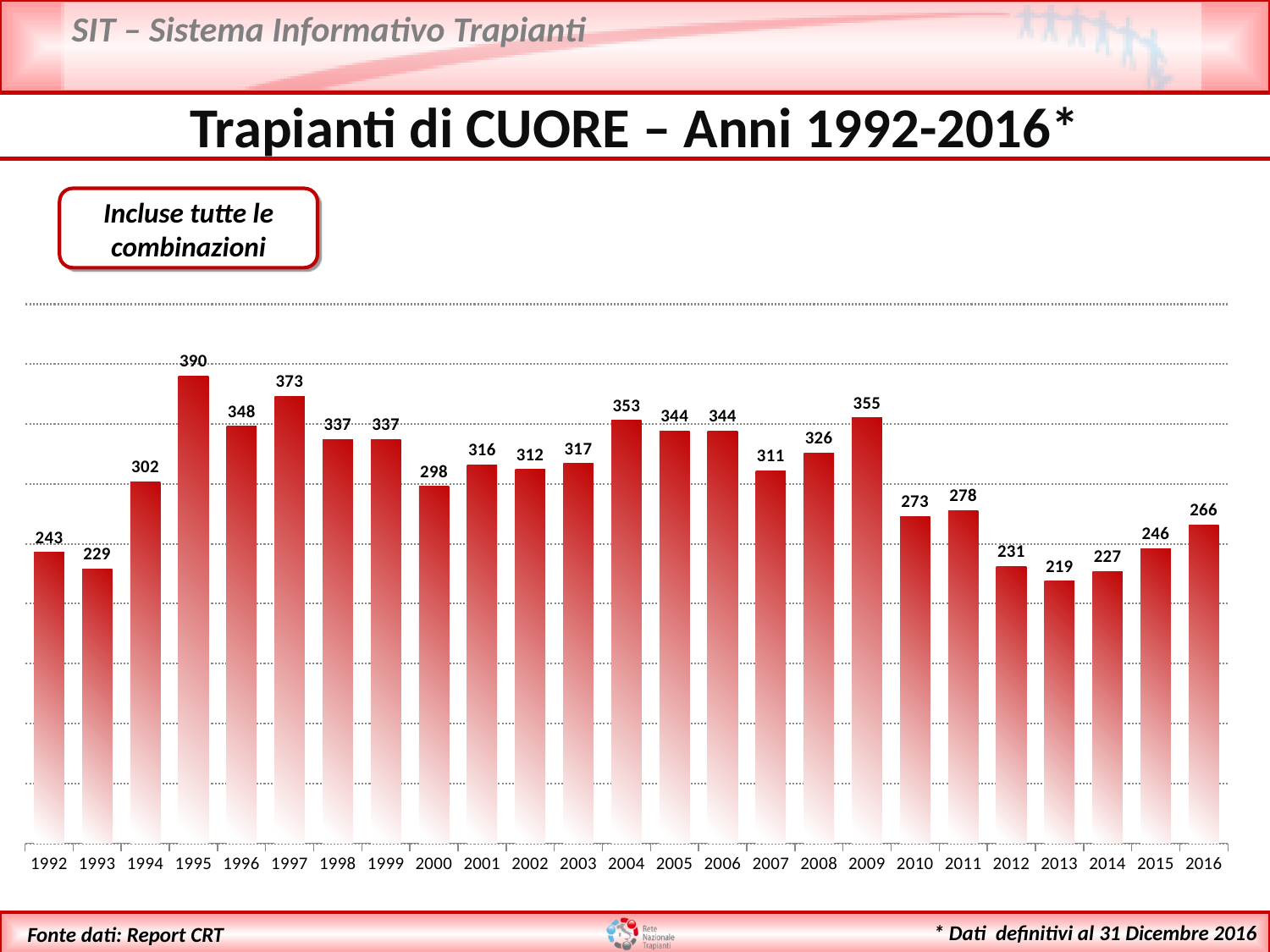
Which is larger, the value for 1997 or the value for 2004? 1997 What is the difference between the values for 2016 and 2015? 20 What is the difference between the values for 1995 and 2013? 171 Which year has the highest value? 1995 What is the title of the chart? Trapianti di CUORE – Anni 1992-2016* Which is larger, the value for 2010 or the value for 2011? 2011 How many years are shown on the x axis? 25 What is the value for 2013? 219 What is the value for 2009? 355 What is the value for 1995? 390 What kind of chart is shown on the slide? Bar chart Which year has the lowest value? 2013